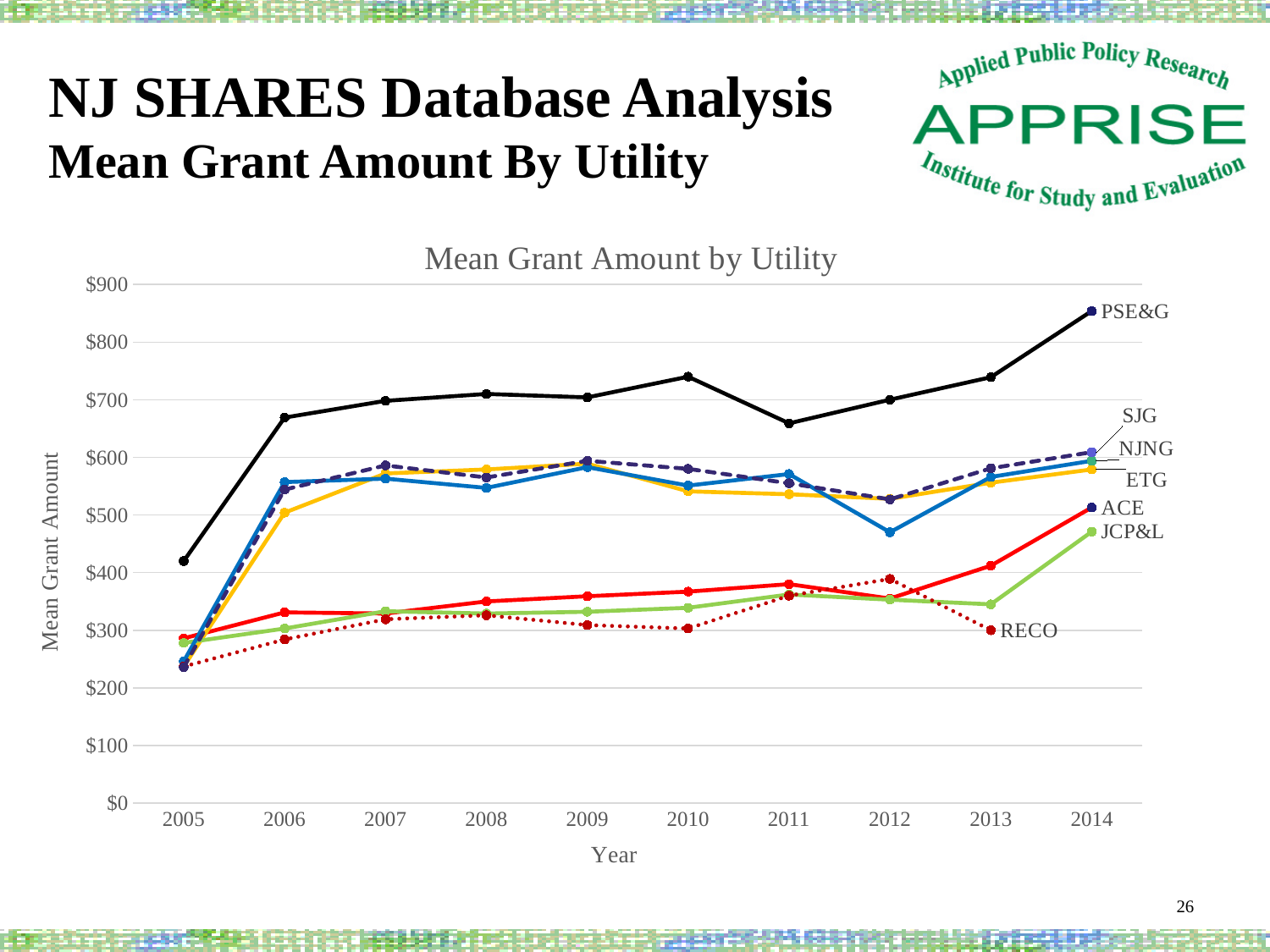
Is the mean grant amount for JCP&L in 2014 greater or less than $500? less Is the mean grant amount for PSE&G in 2014 greater or less than $800? greater What is the title of the chart? Mean Grant Amount by Utility What kind of chart is shown on the slide? Line chart How many utilities are plotted as separate lines in the chart? 7 How many years are plotted along the x axis of the chart? 10 In 2011, which utility has the larger mean grant amount, PSE&G or ACE? PSE&G Does the mean grant amount for PSE&G rise or fall overall from 2005 to 2014? rise Which utility is drawn with a dotted red line in the chart? RECO Which utility has the lowest mean grant amount in 2014? JCP&L Which utility has the highest mean grant amount in 2014? PSE&G Is the mean grant amount for RECO in 2005 greater or less than $300? less